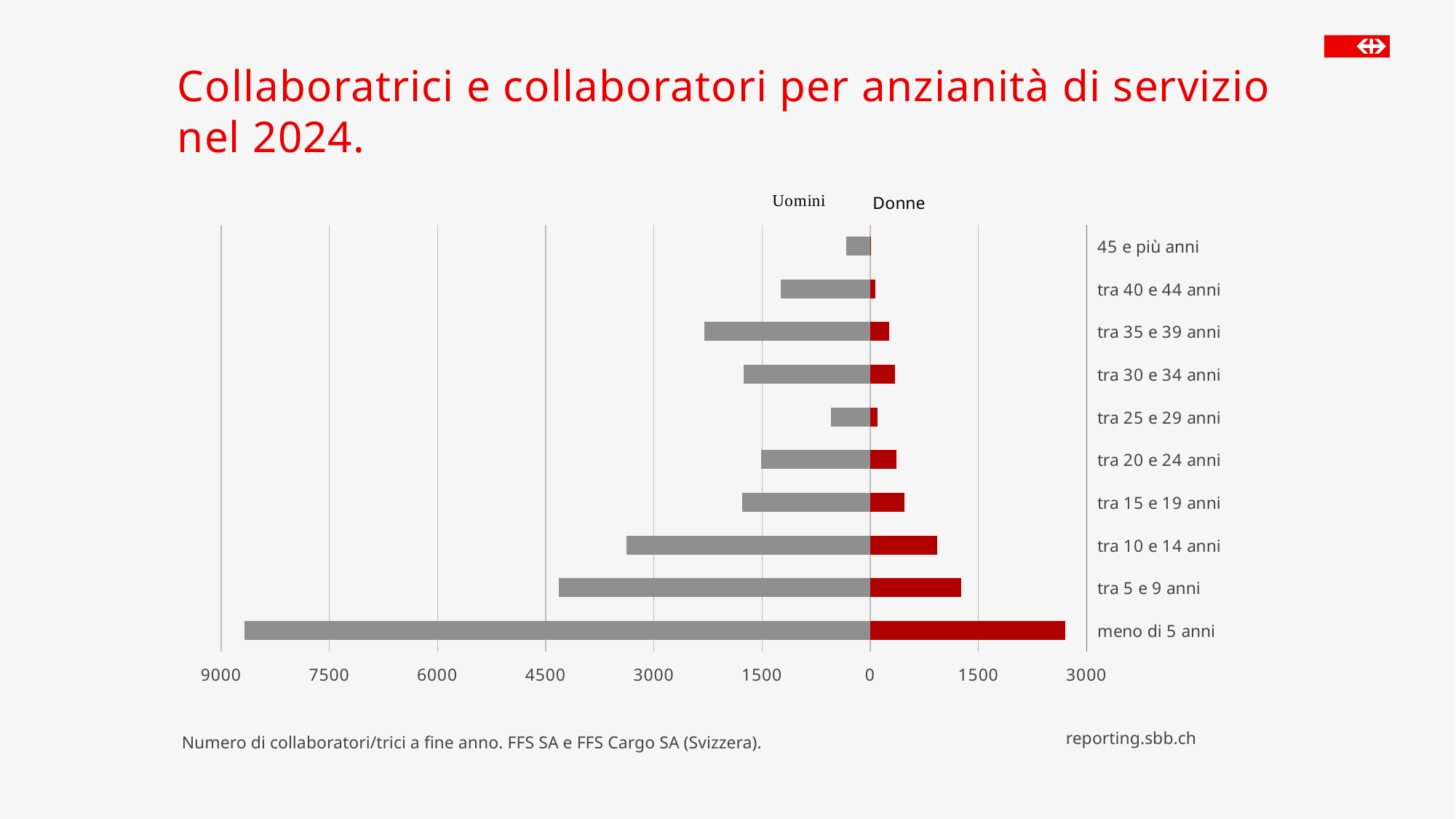
Which is larger for Donne: 'tra 5 e 9 anni' or 'tra 10 e 14 anni'? tra 5 e 9 anni Which is larger for Uomini: 'tra 35 e 39 anni' or 'tra 30 e 34 anni'? tra 35 e 39 anni How many service-seniority categories does the chart show? 10 Is the value for Uomini in the category 'tra 25 e 29 anni' greater or less than 1500? less Which colour represents the Donne series in the chart? red How many series does the chart show? 2 Is the value for Uomini in the category 'meno di 5 anni' greater or less than 7500? greater Is the value for Donne in the category 'meno di 5 anni' greater or less than 1500? greater Which category has the highest value for Uomini? meno di 5 anni What kind of chart is shown on the slide? bar chart Which category has the lowest value for Donne? 45 e più anni